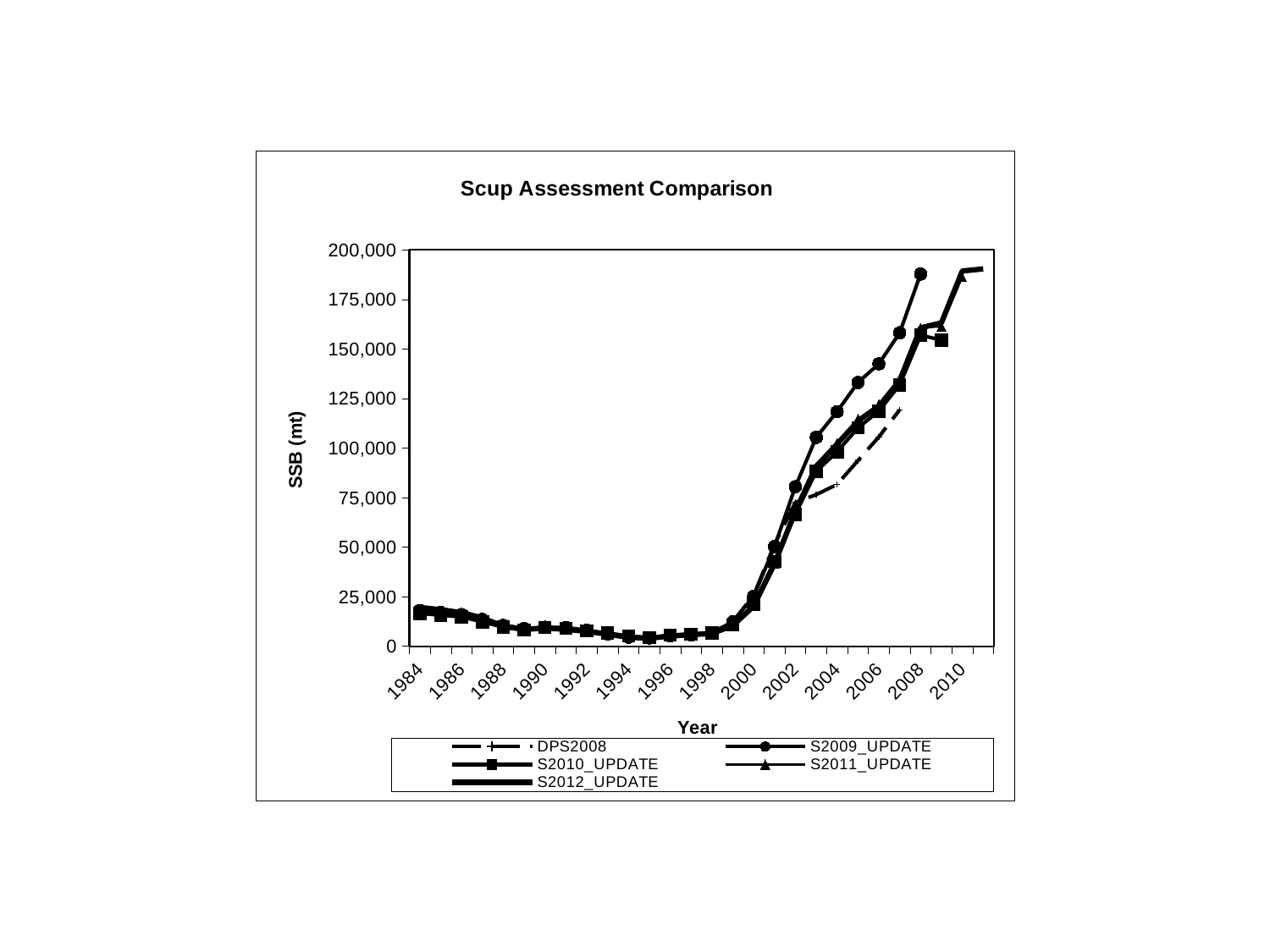
Is the value for S2009_UPDATE in 2008 greater or less than 175,000? greater Do the SSB values rise or fall from 1998 to 2008? rise In 2007, which series has the larger value, S2009_UPDATE or DPS2008? S2009_UPDATE What is the title of the chart? Scup Assessment Comparison Is the value for DPS2008 in 2007 greater or less than 100,000? greater Are the SSB values in 1995 greater or less than 25,000? less What kind of chart is shown on the slide? line chart How many series does the legend list? 5 What is the label of the y axis? SSB (mt)